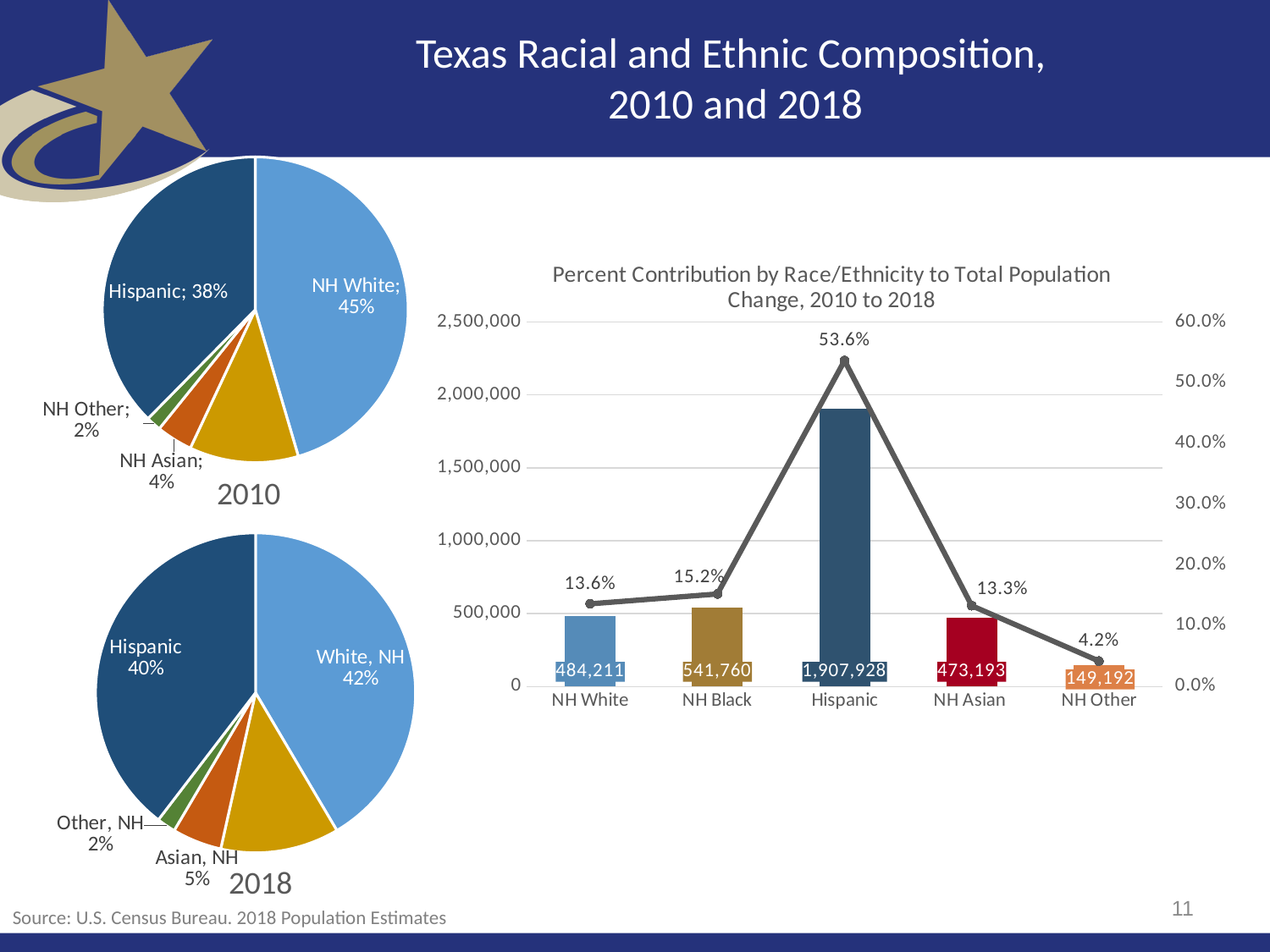
In the 'Percent Contribution by Race/Ethnicity to Total Population Change, 2010 to 2018' chart, what is the population change value for NH Black? 541,760 In the 'Percent Contribution by Race/Ethnicity to Total Population Change, 2010 to 2018' chart, which category has the lowest population change value? NH Other In the 'Percent Contribution by Race/Ethnicity to Total Population Change, 2010 to 2018' chart, is the percent contribution for NH Black greater or less than the percent contribution for NH White? greater In the 'Percent Contribution by Race/Ethnicity to Total Population Change, 2010 to 2018' chart, what percent contribution is shown for NH Other? 4.2% In the 2018 pie chart, what share of the population is Asian, NH? 5% In the 'Percent Contribution by Race/Ethnicity to Total Population Change, 2010 to 2018' chart, how many categories are shown on the x axis? 5 In the 'Percent Contribution by Race/Ethnicity to Total Population Change, 2010 to 2018' chart, which category has the highest percent contribution? Hispanic In the 'Percent Contribution by Race/Ethnicity to Total Population Change, 2010 to 2018' chart, what is the difference between the population change values for NH White and NH Asian? 11,018 In the 2010 pie chart, what share of the population is Hispanic? 38% In the 'Percent Contribution by Race/Ethnicity to Total Population Change, 2010 to 2018' chart, what is the population change value for Hispanic? 1,907,928 In the 2018 pie chart, what share of the population is White, NH? 42% What kind of chart is the 2010 chart on the left of the slide? Pie chart